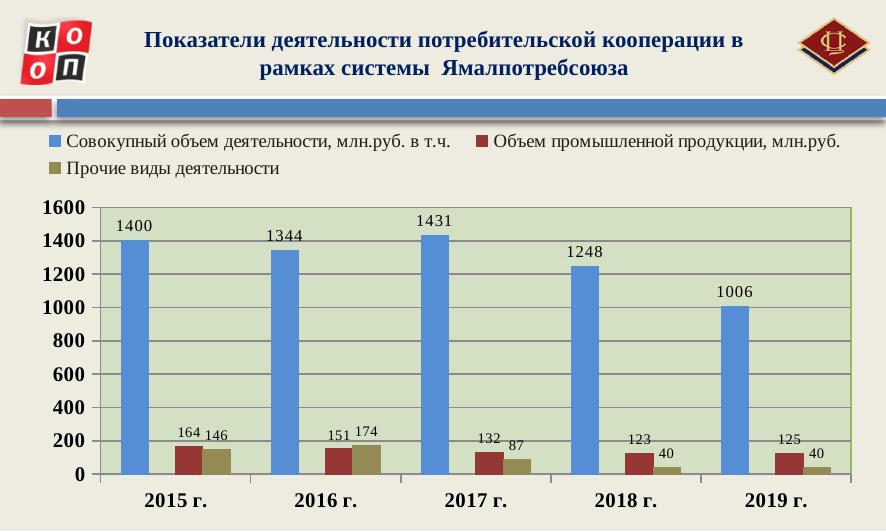
What is the value of "Прочие виды деятельности" for 2016 г.? 174 Is the value of "Совокупный объем деятельности, млн.руб. в т.ч." for 2018 г. greater or less than 1200? greater In which year is "Совокупный объем деятельности, млн.руб. в т.ч." the highest? 2017 г. Does "Прочие виды деятельности" rise or fall from 2016 г. to 2018 г.? fall How many years are shown on the x axis? 5 Which is larger for 2016 г.: "Объем промышленной продукции, млн.руб." or "Прочие виды деятельности"? Прочие виды деятельности What is the difference between "Совокупный объем деятельности, млн.руб. в т.ч." in 2015 г. and in 2019 г.? 394 What kind of chart is shown on the slide? bar chart What is the value of "Объем промышленной продукции, млн.руб." for 2015 г.? 164 What is the value of "Совокупный объем деятельности, млн.руб. в т.ч." for 2017 г.? 1431 How many series does the legend list? 3 In which year is "Совокупный объем деятельности, млн.руб. в т.ч." the lowest? 2019 г.